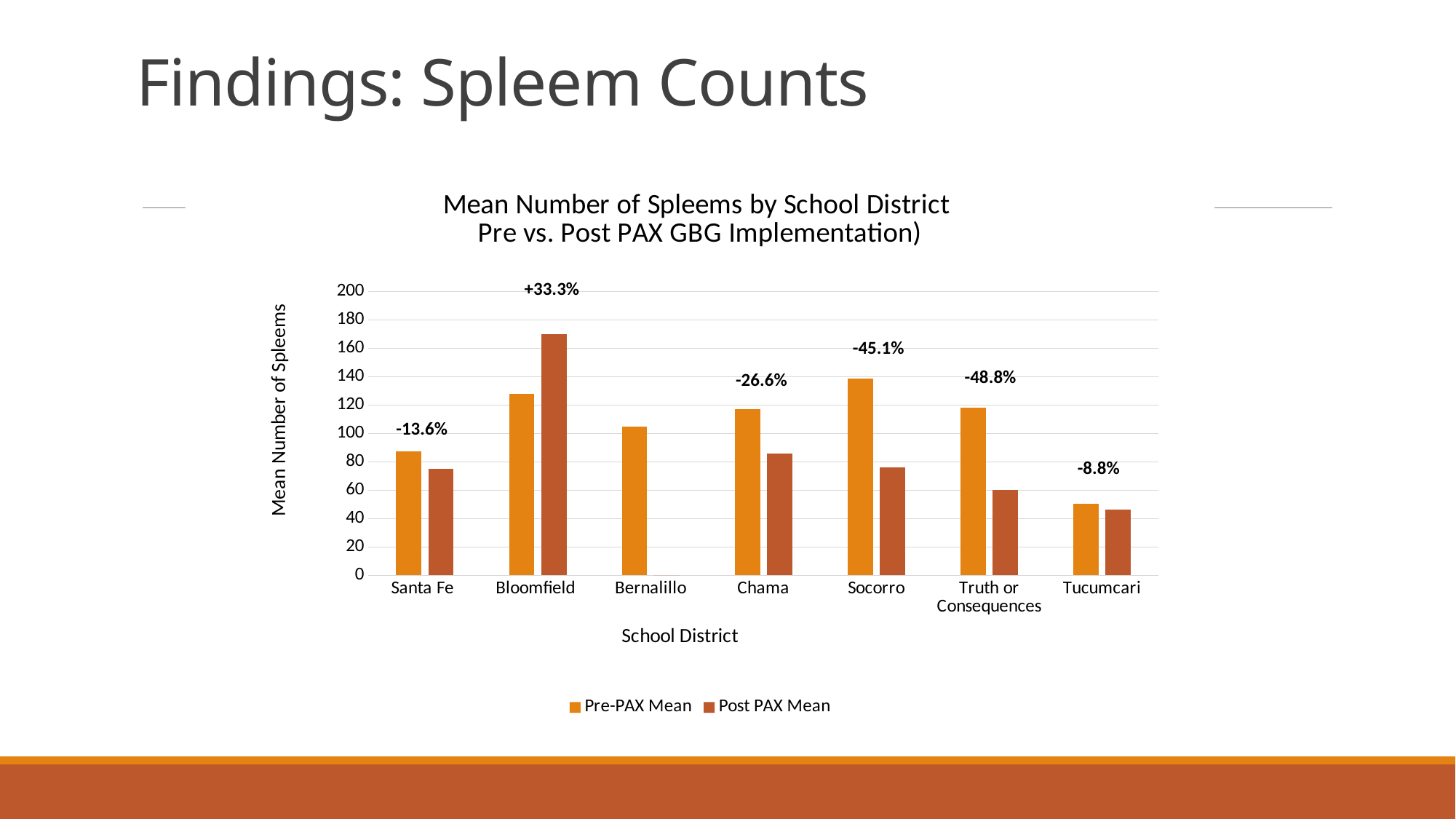
For Socorro, which is larger, the Pre-PAX Mean or the Post PAX Mean? Pre-PAX Mean Which school district has the highest Post PAX Mean? Bloomfield What kind of chart is shown on the slide? bar chart Which school district has no Post PAX Mean bar shown? Bernalillo What percentage change label is printed above the Socorro bars? -45.1% What percentage change label is printed above the Truth or Consequences bars? -48.8% Is the Post PAX Mean for Santa Fe greater or less than 80? less What percentage change label is printed above the Bloomfield bars? +33.3% Is the Post PAX Mean for Bloomfield greater or less than 160? greater Which school district has the lowest Pre-PAX Mean? Tucumcari How many series does the legend list? 2 How many school districts are shown on the x axis? 7